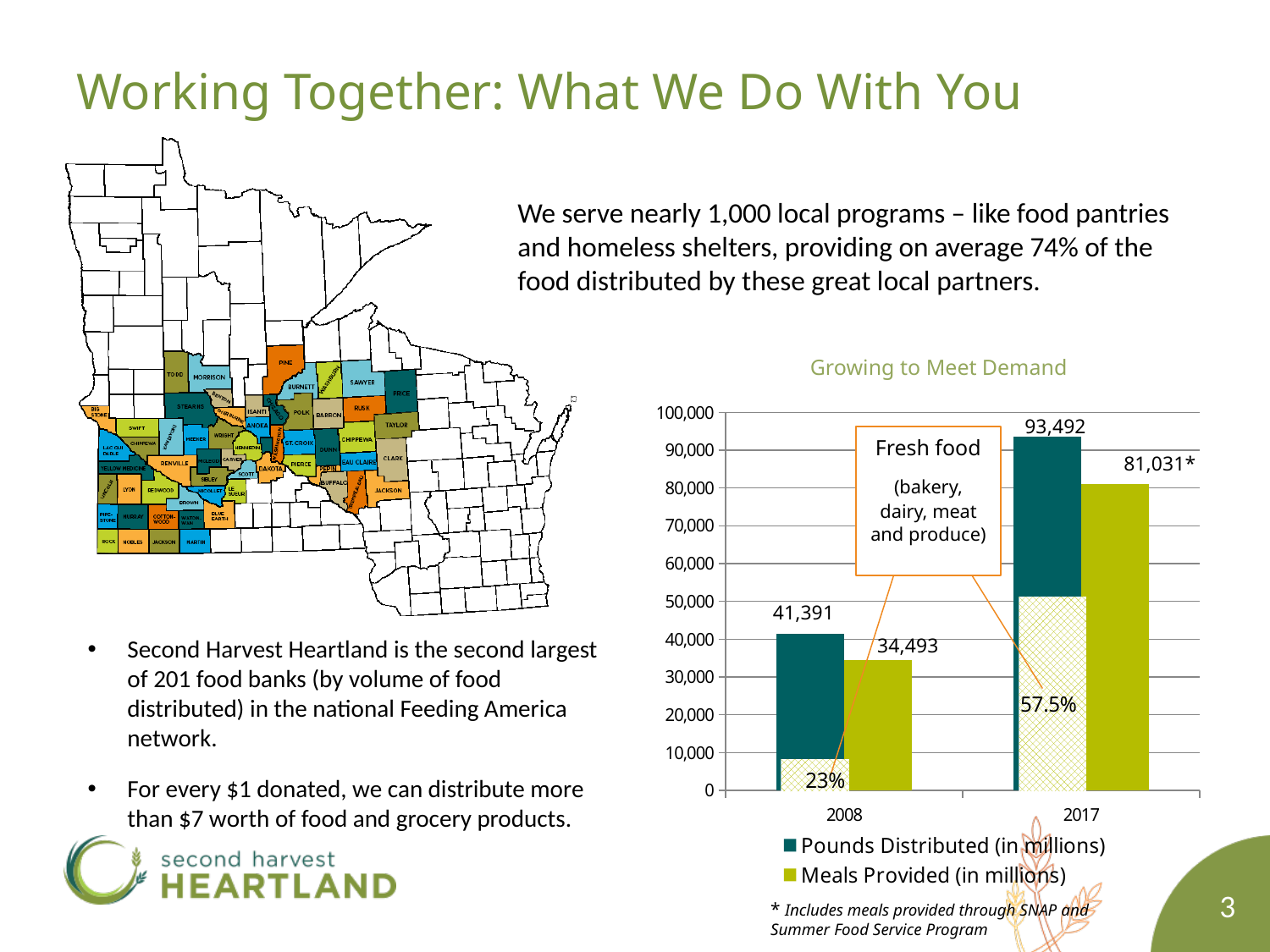
How many years are shown on the x axis of the "Growing to Meet Demand" chart? 2 What type of chart is shown under the title "Growing to Meet Demand"? bar chart What is the value for Pounds Distributed (in millions) in 2017? 93,492 How many series does the legend of the "Growing to Meet Demand" chart list? 2 Which year has the higher value for Pounds Distributed (in millions)? 2017 What is the value for Meals Provided (in millions) in 2017? 81,031 What is the value for Meals Provided (in millions) in 2008? 34,493 Does the value for Pounds Distributed (in millions) rise or fall from 2008 to 2017? rise What percentage of the 2017 Pounds Distributed bar is labelled as fresh food? 57.5% What is the difference between Pounds Distributed (in millions) in 2017 and in 2008? 52,101 What is the value for Pounds Distributed (in millions) in 2008? 41,391 What is the title of the chart on the slide? Growing to Meet Demand